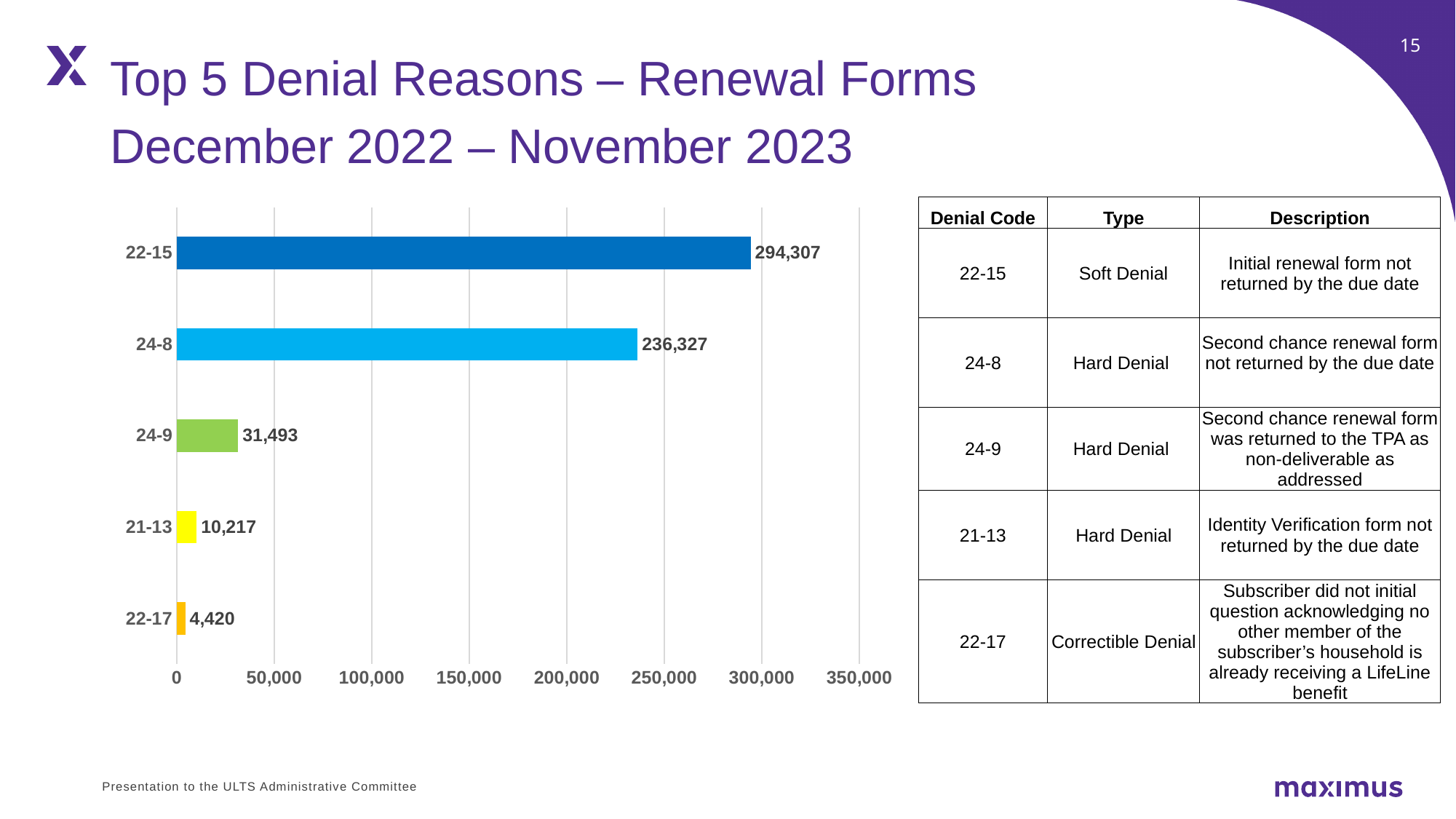
What is the difference between the values for 24-9 and 21-13? 21,276 What is the value for denial code 22-15? 294,307 How many denial codes are plotted in the chart? 5 Which denial code has the highest value? 22-15 What is the value for denial code 24-9? 31,493 Which denial code has the lowest value? 22-17 What is the difference between the values for 22-15 and 24-8? 57,980 Which has a larger value, 21-13 or 24-9? 24-9 What is the value for denial code 22-17? 4,420 Is the value for 24-8 greater or less than 250,000? less What is the value for denial code 24-8? 236,327 What kind of chart is shown on the slide? bar chart